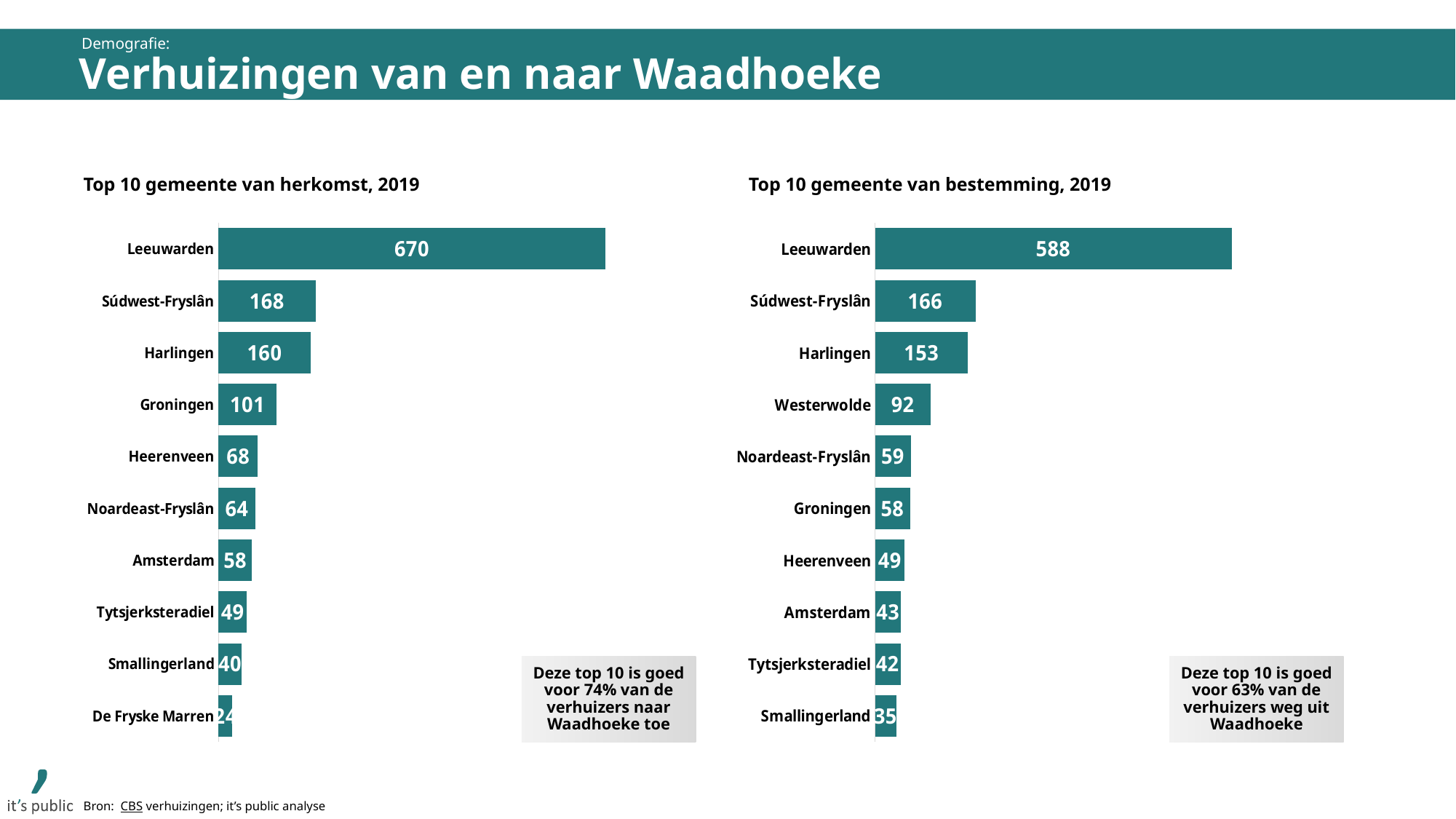
What kind of chart is 'Top 10 gemeente van bestemming, 2019'? Bar chart In the chart 'Top 10 gemeente van herkomst, 2019', what is the value for Groningen? 101 In the chart 'Top 10 gemeente van bestemming, 2019', what is the value for Westerwolde? 92 In the chart 'Top 10 gemeente van herkomst, 2019', which gemeente has the highest value? Leeuwarden How many gemeenten are shown in the chart 'Top 10 gemeente van herkomst, 2019'? 10 In the chart 'Top 10 gemeente van herkomst, 2019', which is larger: the value for Heerenveen or the value for Amsterdam? Heerenveen In the chart 'Top 10 gemeente van bestemming, 2019', what is the difference between the values for Harlingen and Heerenveen? 104 In the chart 'Top 10 gemeente van bestemming, 2019', which gemeente has the lowest value? Smallingerland In the chart 'Top 10 gemeente van herkomst, 2019', what is the value for De Fryske Marren? 24 According to the text box next to the chart 'Top 10 gemeente van bestemming, 2019', what share of the verhuizers weg uit Waadhoeke does this top 10 account for? 63% In the chart 'Top 10 gemeente van bestemming, 2019', which is larger: the value for Groningen or the value for Tytsjerksteradiel? Groningen In the chart 'Top 10 gemeente van herkomst, 2019', what is the difference between the values for Leeuwarden and Súdwest-Fryslân? 502